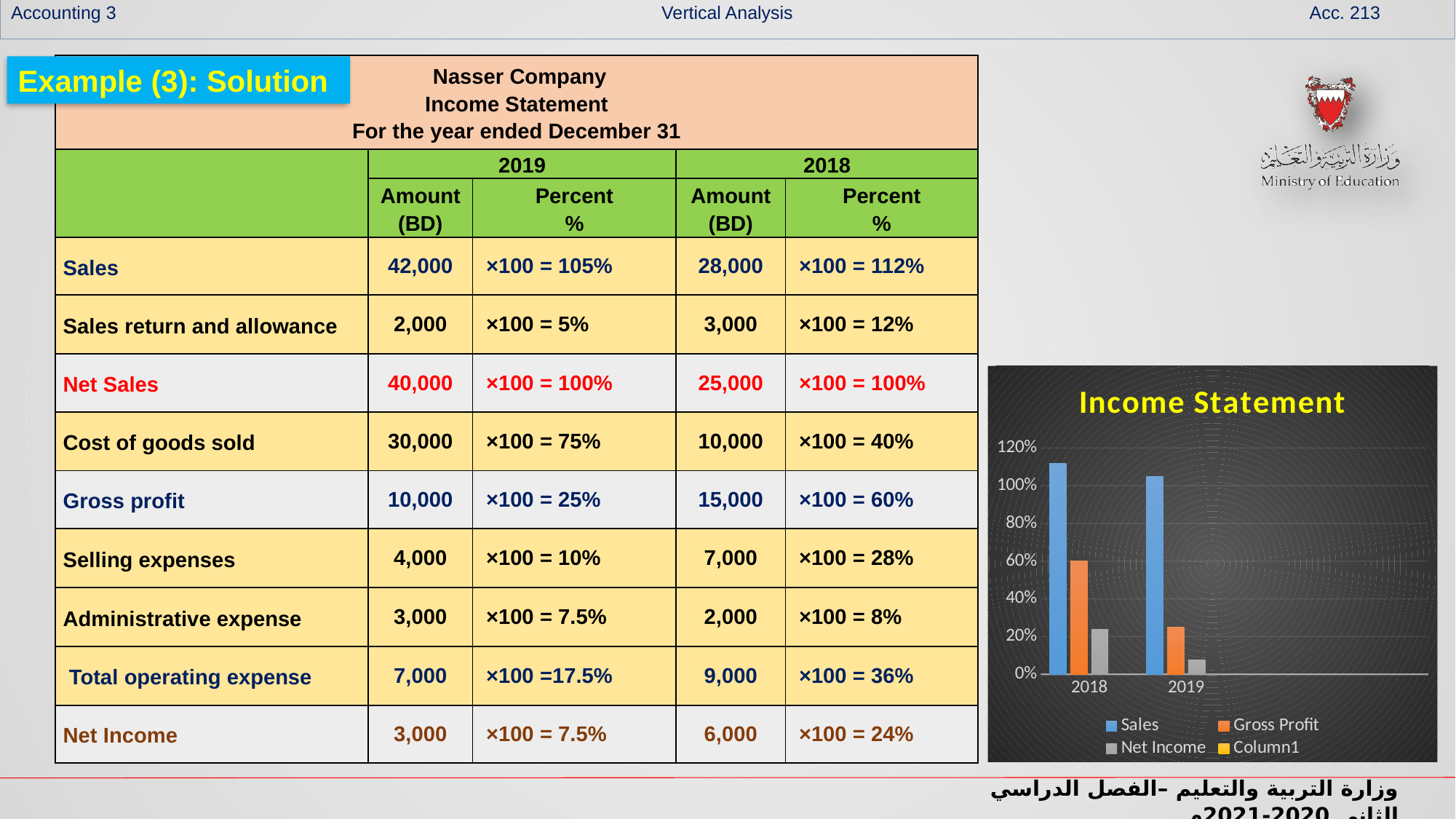
In the Income Statement chart, is the Gross Profit value for 2018 greater or less than 40%? greater What is the title of the chart on the slide? Income Statement What kind of chart is the Income Statement chart? bar chart In the Income Statement chart, which series is shown in blue? Sales In the Income Statement chart, is the Net Income value for 2019 greater or less than 20%? less In the Income Statement chart, which series has the tallest bar for 2018? Sales In the Income Statement chart, which series has the shortest bar for 2019? Net Income In the Income Statement chart, is the Gross Profit value for 2019 greater or less than 40%? less How many year categories are shown on the x axis of the Income Statement chart? 2 How many series does the legend of the Income Statement chart list? 4 In the Income Statement chart, is Gross Profit larger in 2018 or in 2019? 2018